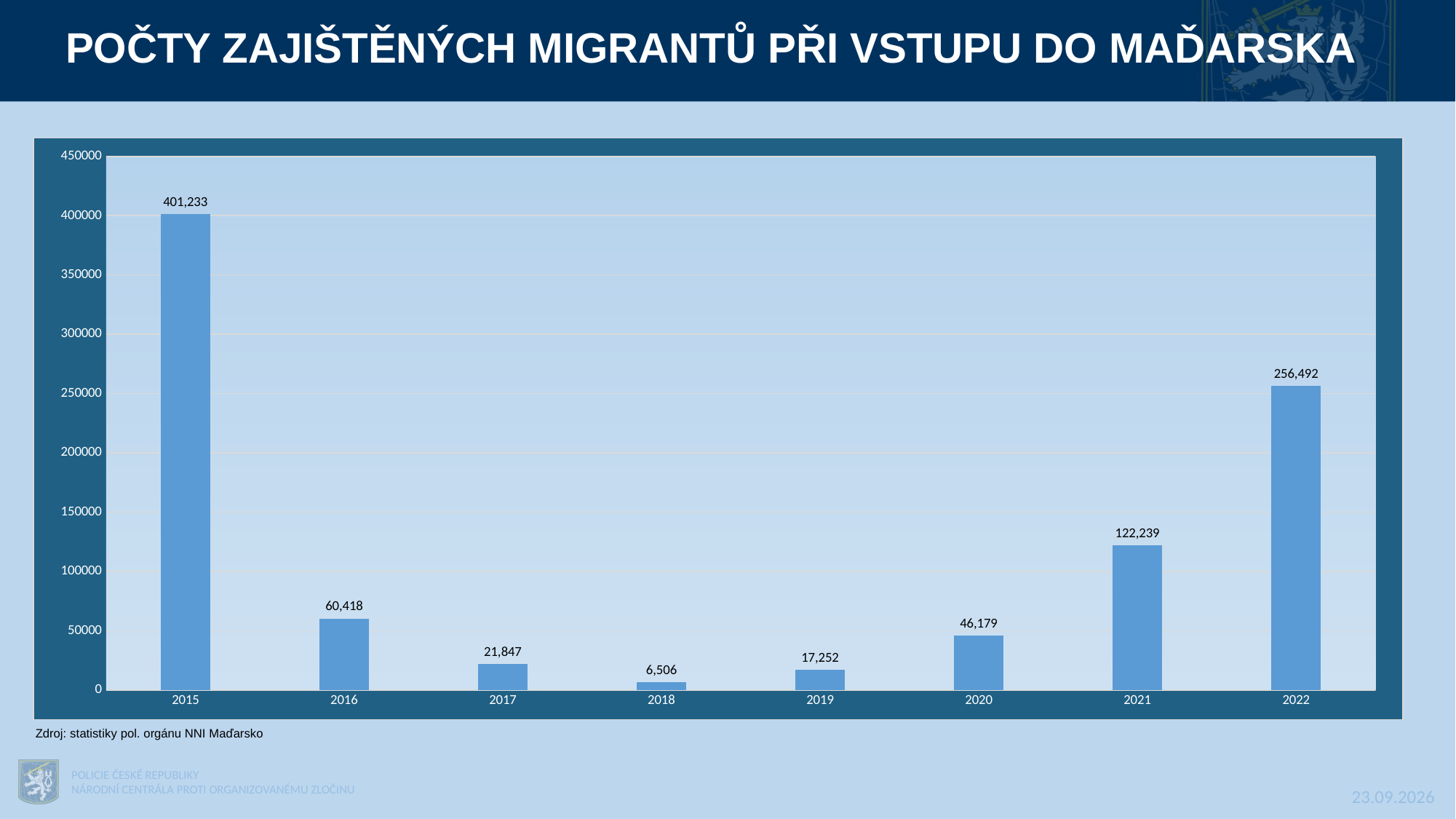
What is the value for 2022? 256,492 Is the value for 2021 greater or less than 100000? greater Which is larger, the value for 2016 or the value for 2020? 2016 What is the difference between the values for 2015 and 2022? 144,741 Which year has the lowest value? 2018 What is the difference between the values for 2022 and 2021? 134,253 What kind of chart is shown on the slide? bar chart What is the value for 2015? 401,233 Which year has the highest value? 2015 How many years are shown on the x axis? 8 What is the value for 2018? 6,506 What is the value for 2020? 46,179